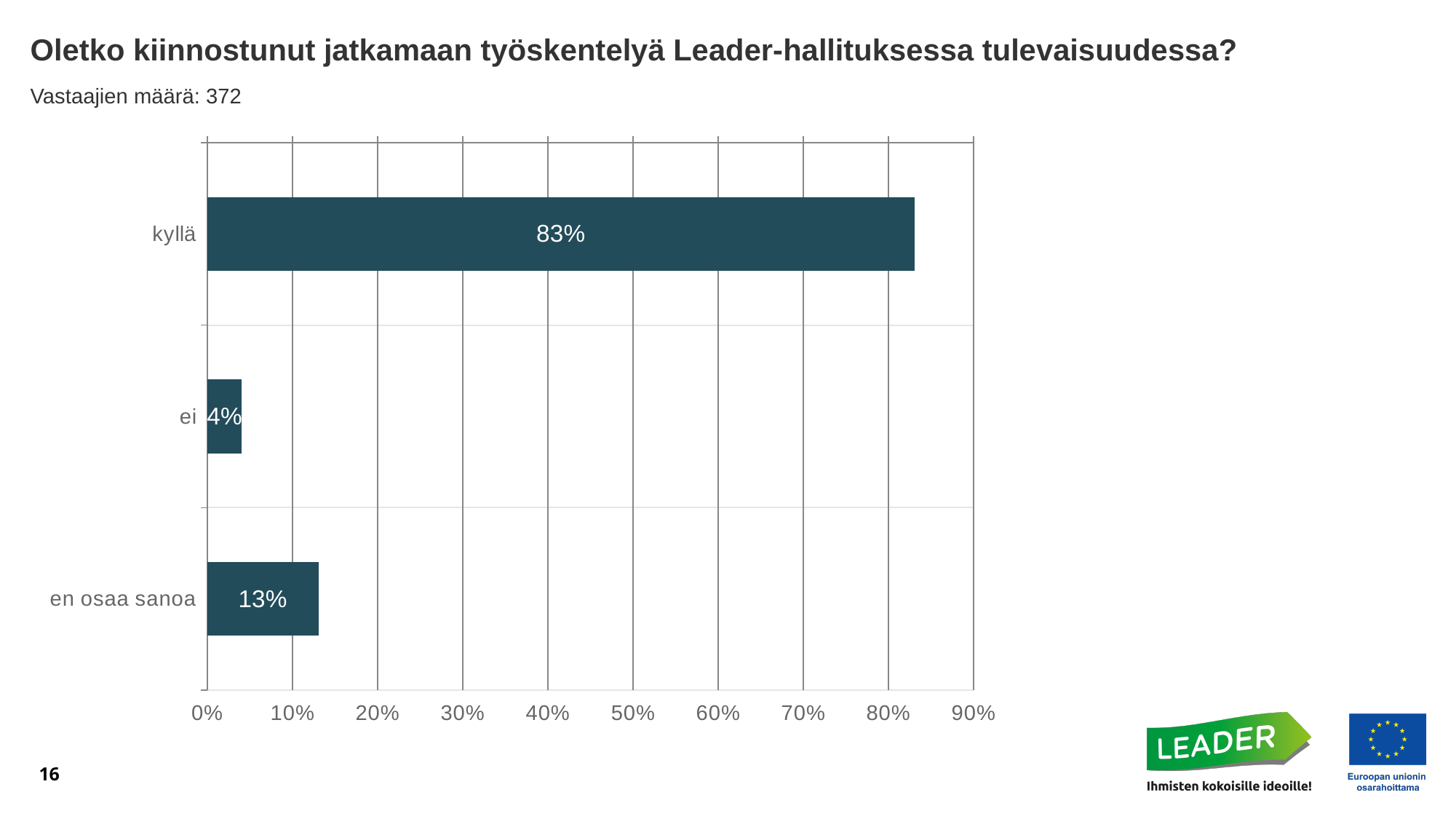
How many respondents does the slide report (Vastaajien määrä)? 372 Which is larger, the value for "ei" or the value for "en osaa sanoa"? en osaa sanoa What is the difference between the values for "en osaa sanoa" and "ei"? 9% Is the value for "kyllä" greater or less than 80%? greater Which category has the highest value? kyllä What is the value for "en osaa sanoa"? 13% How many categories are shown in the chart? 3 What is the value for "ei"? 4% Which category has the lowest value? ei What is the value for "kyllä"? 83% What kind of chart is shown on the slide? bar chart What is the difference between the values for "kyllä" and "en osaa sanoa"? 70%